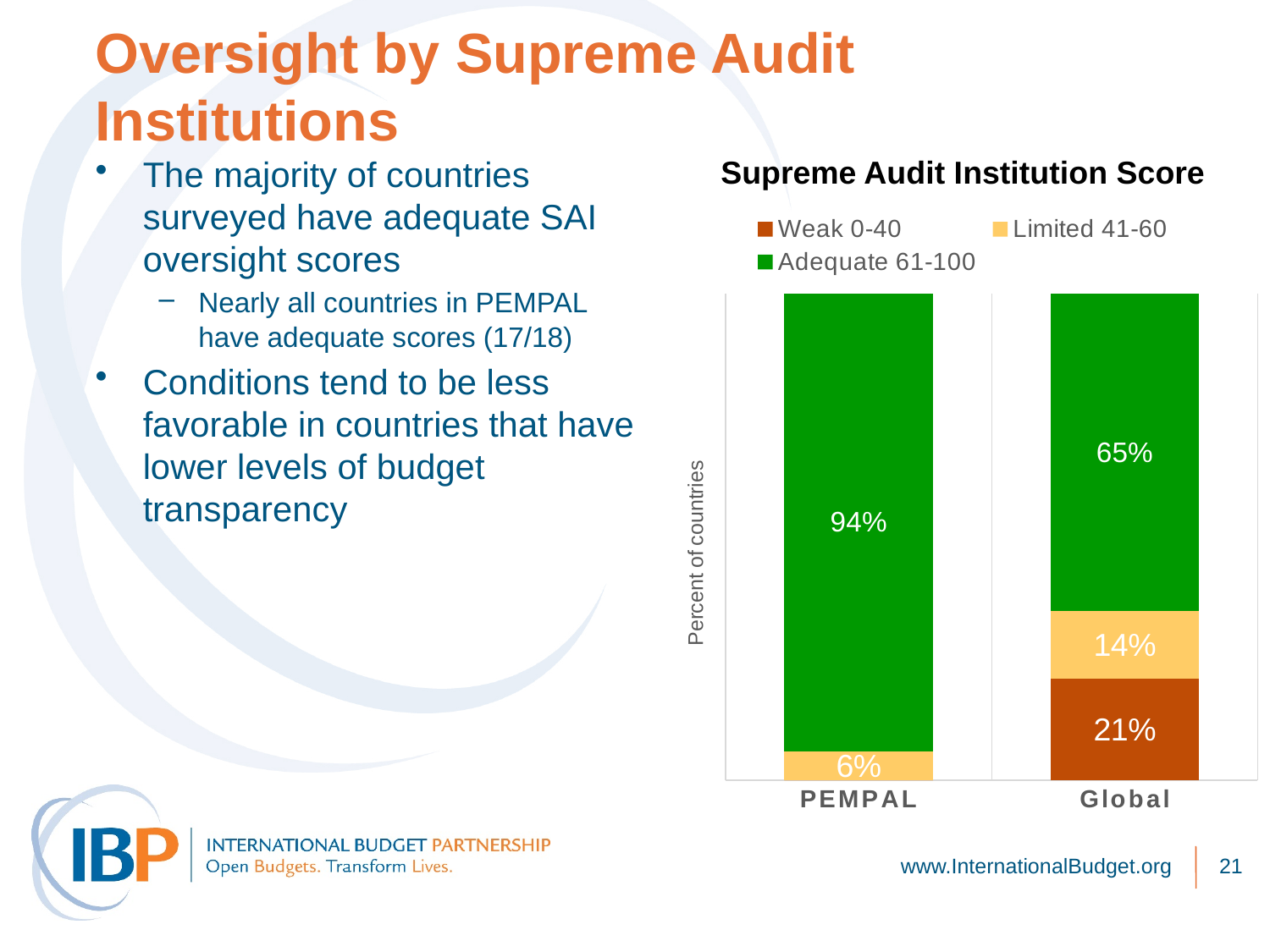
What kind of chart is shown on the slide? Stacked bar chart What is the Weak 0-40 value for Global? 21% Which category has the higher Adequate 61-100 value, PEMPAL or Global? PEMPAL What is the Adequate 61-100 value for PEMPAL? 94% How many categories are shown on the x axis of the chart? 2 How many series does the chart legend list? 3 What is the Limited 41-60 value for Global? 14% What is the difference between the Adequate 61-100 values for PEMPAL and Global? 29% What is the title of the chart? Supreme Audit Institution Score What is the Limited 41-60 value for PEMPAL? 6% What is the Adequate 61-100 value for Global? 65% What is the label of the y axis? Percent of countries